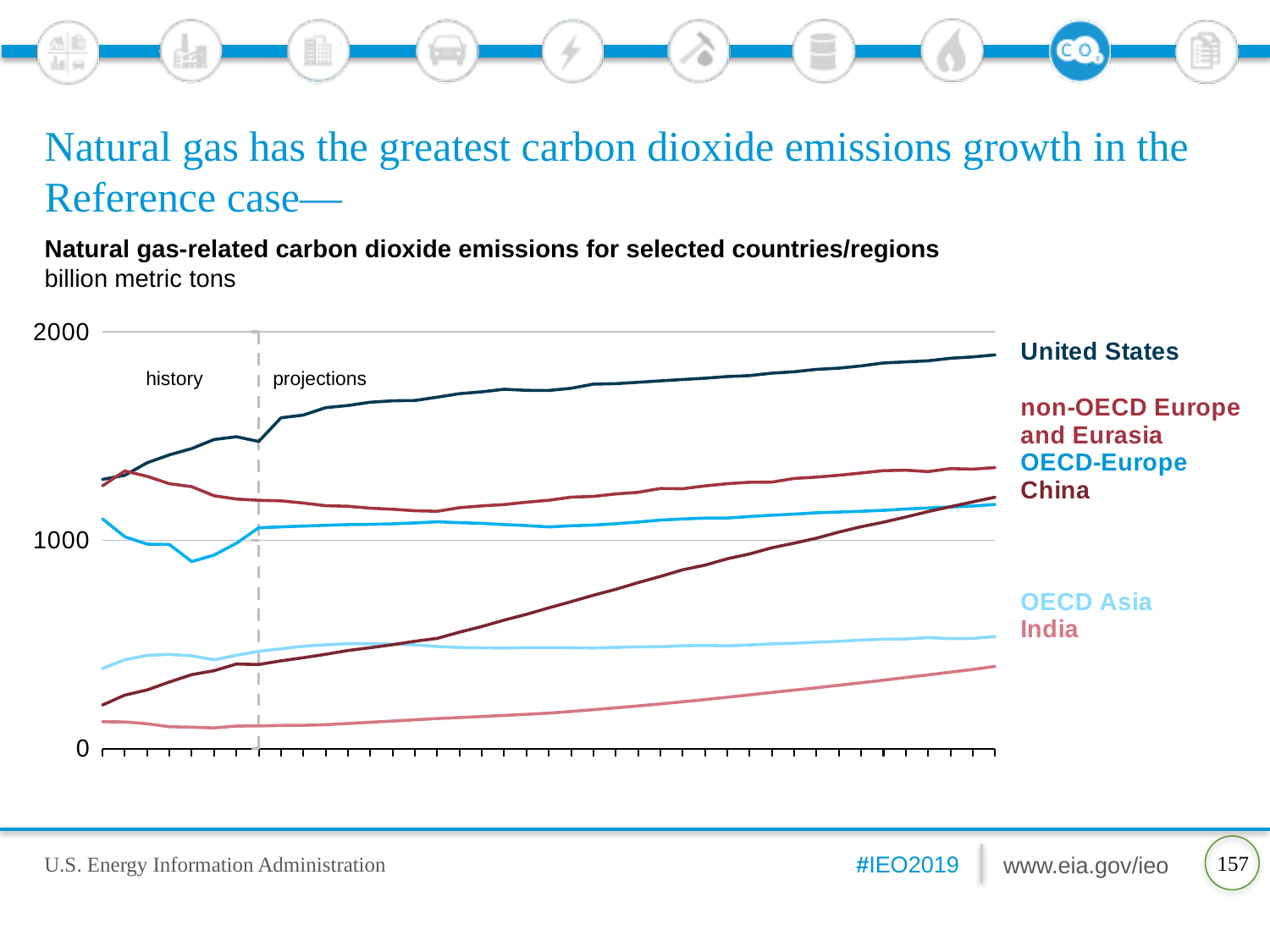
What kind of chart is shown on the slide? line chart What unit is used for the values on the chart? billion metric tons Is the value for India at the right end of the chart greater or less than 1000? less Does the line for the United States rise or fall across the projection period? rise Which is larger at the right end of the chart, the value for the United States or the value for India? United States What two periods does the dashed vertical line separate on the chart? history and projections Which country/region has the lowest natural gas-related carbon dioxide emissions at the right end of the chart? India Is the value for OECD Asia at the right end of the chart greater or less than 1000? less Does the line for China rise or fall across the projection period? rise How many countries/regions are plotted as series on the chart? 6 Which country/region has the highest natural gas-related carbon dioxide emissions at the right end of the chart? United States Is the value for the United States at the right end of the chart greater or less than 1000? greater